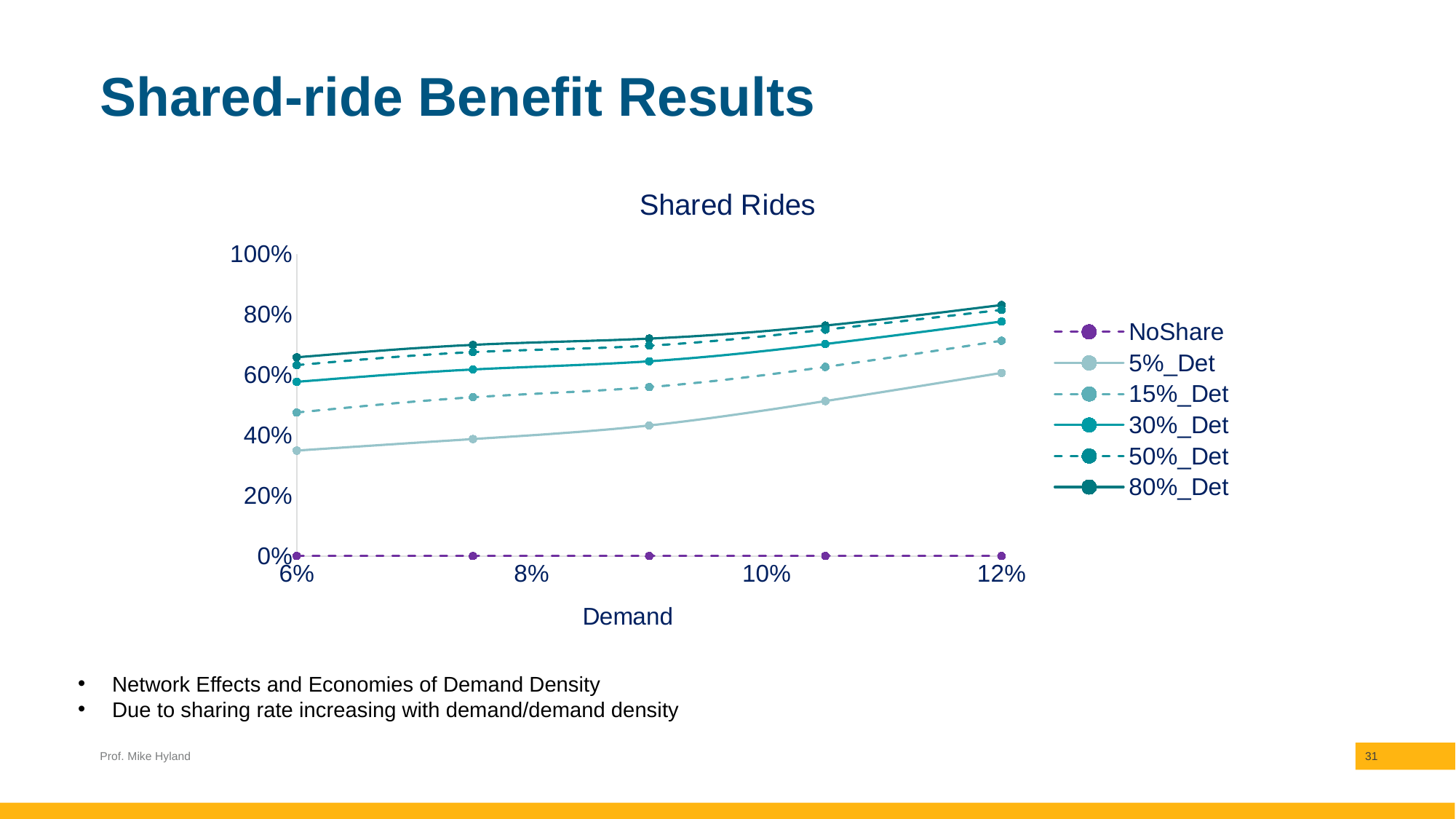
What is the title of the chart? Shared Rides Is the value for 80%_Det at 12% demand greater or less than 80%? greater At 12% demand, which is larger: the value for 5%_Det or the value for 30%_Det? 30%_Det What is the value of the NoShare series at 6% demand? 0% How many series does the legend list? 6 Do the values for 5%_Det rise or fall as demand increases from 6% to 12%? rise Which series has the highest value at 12% demand? 80%_Det Is the value for 15%_Det at 6% demand greater or less than 60%? less Is the value for 5%_Det at 6% demand greater or less than 40%? less How many data points are plotted for each series along the Demand axis? 5 What kind of chart is shown on the slide? line chart Which series has the lowest values across all demand levels? NoShare